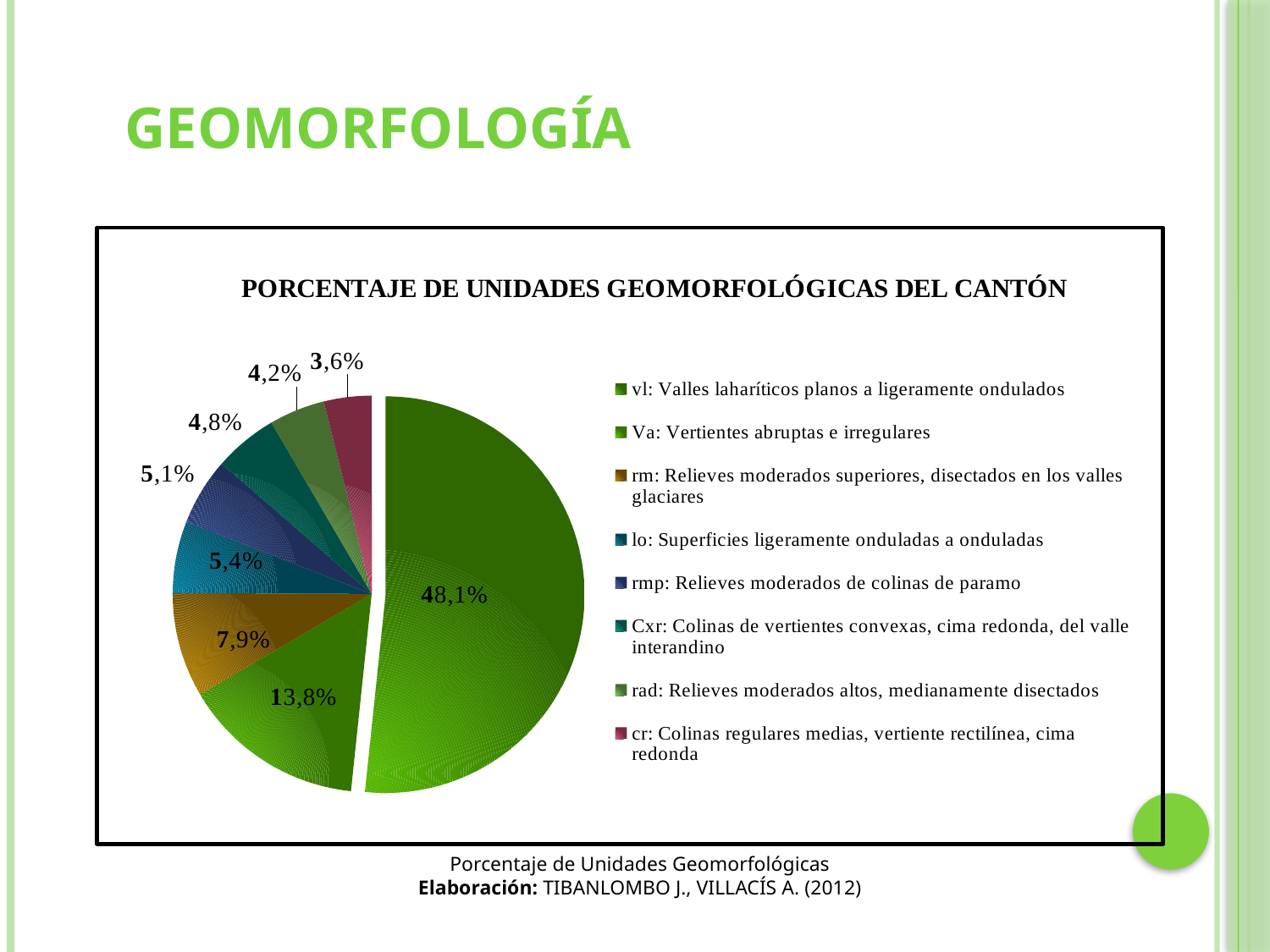
What percentage is shown for the brown slice of the pie chart? 7,9% What is the difference between the largest slice (48,1%) and the second-largest slice (13,8%)? 34,3% How many slices does the pie chart have? 8 What percentage is shown for the largest slice of the pie chart? 48,1% What percentage is shown for the second-largest slice of the pie chart? 13,8% Which legend entry is listed first in the chart's legend? vl: Valles laharíticos planos a ligeramente ondulados What is the title of the chart? PORCENTAJE DE UNIDADES GEOMORFOLÓGICAS DEL CANTÓN Is the largest slice of the pie chart greater or less than 50%? less What is the combined share of the two slices labelled 4,2% and 3,6%? 7,8% What is the smallest percentage shown on the pie chart? 3,6% Which is larger, the slice labelled 5,4% or the slice labelled 5,1%? 5,4% What type of chart is shown on the slide? pie chart